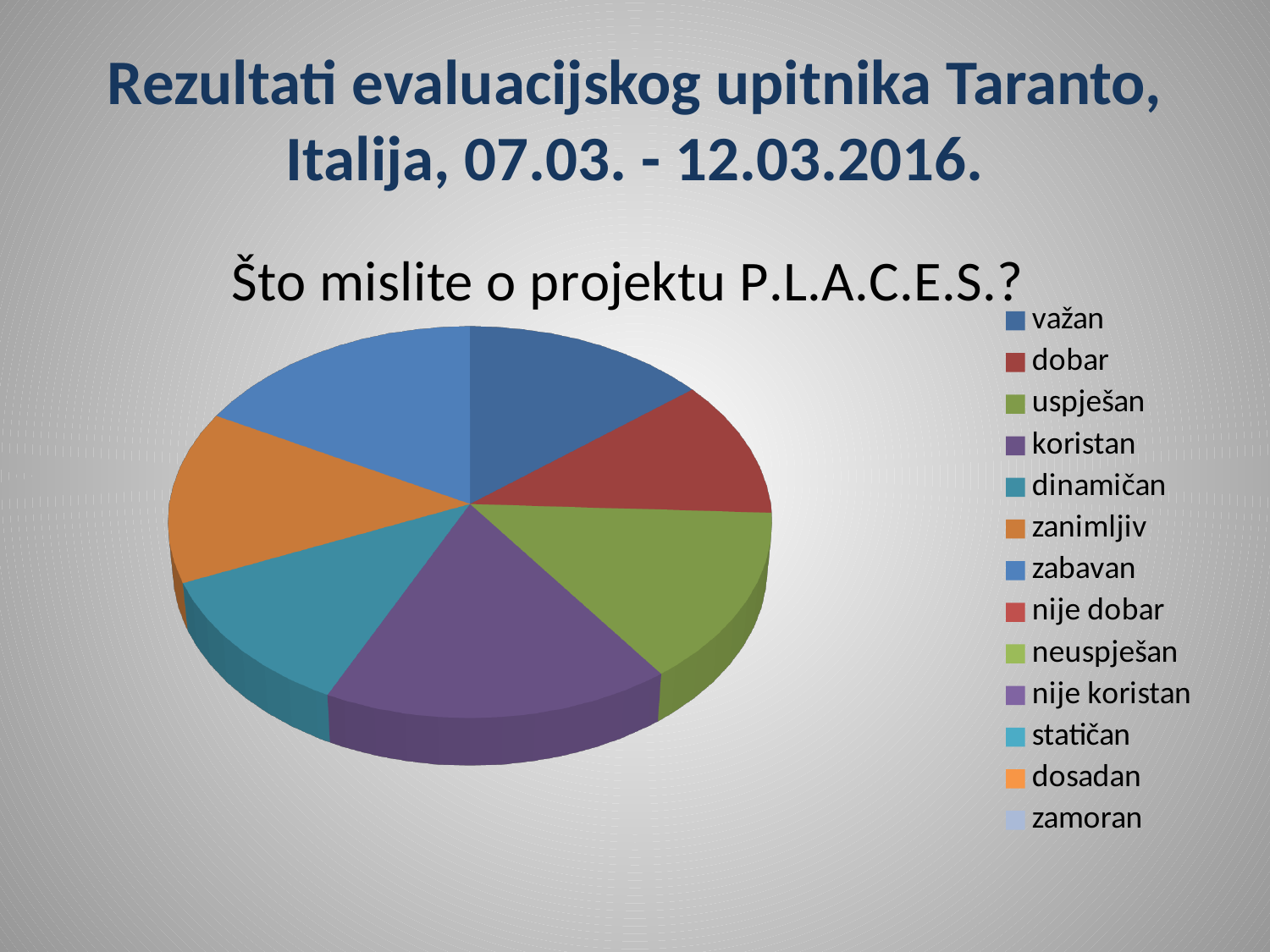
Which slice is larger, koristan or uspješan? koristan Which category is listed first in the legend? važan How many entries does the chart's legend list? 13 What is the title of the chart? Što mislite o projektu P.L.A.C.E.S.? How many slices are visible in the pie chart? 7 What kind of chart is shown on the slide? pie chart Which slice is larger, koristan or dobar? koristan